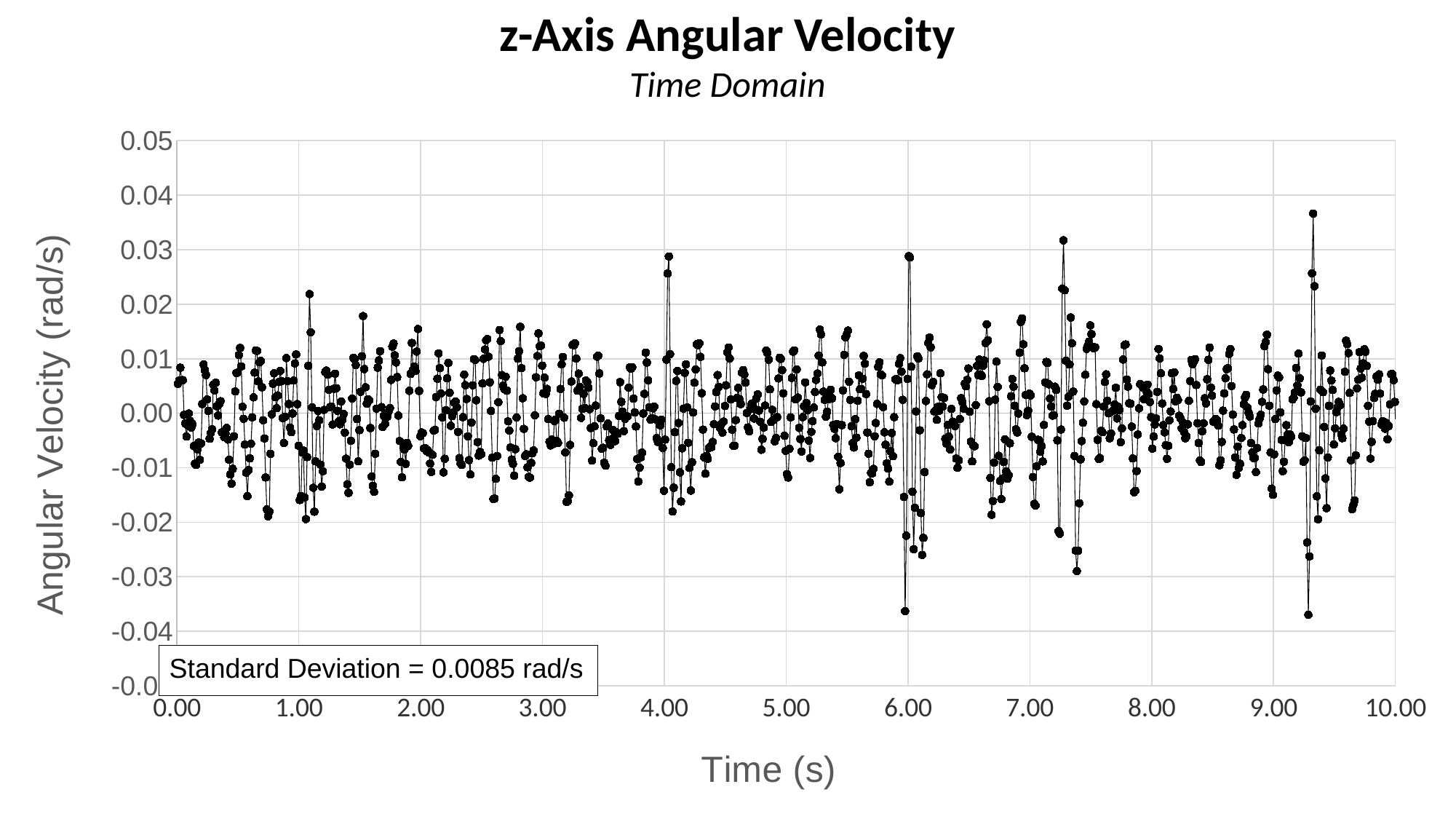
Do the plotted values show a clear overall rising or falling trend across the time axis? no What is the title of the chart? z-Axis Angular Velocity What standard deviation is stated in the text box on the chart? 0.0085 rad/s Is the lowest angular velocity value plotted greater or less than -0.04? greater Is the highest angular velocity value plotted greater or less than 0.04? less Is the lowest angular velocity value plotted greater or less than -0.03? less What is the label on the vertical axis of the chart? Angular Velocity (rad/s) What kind of chart is shown on the slide? line chart